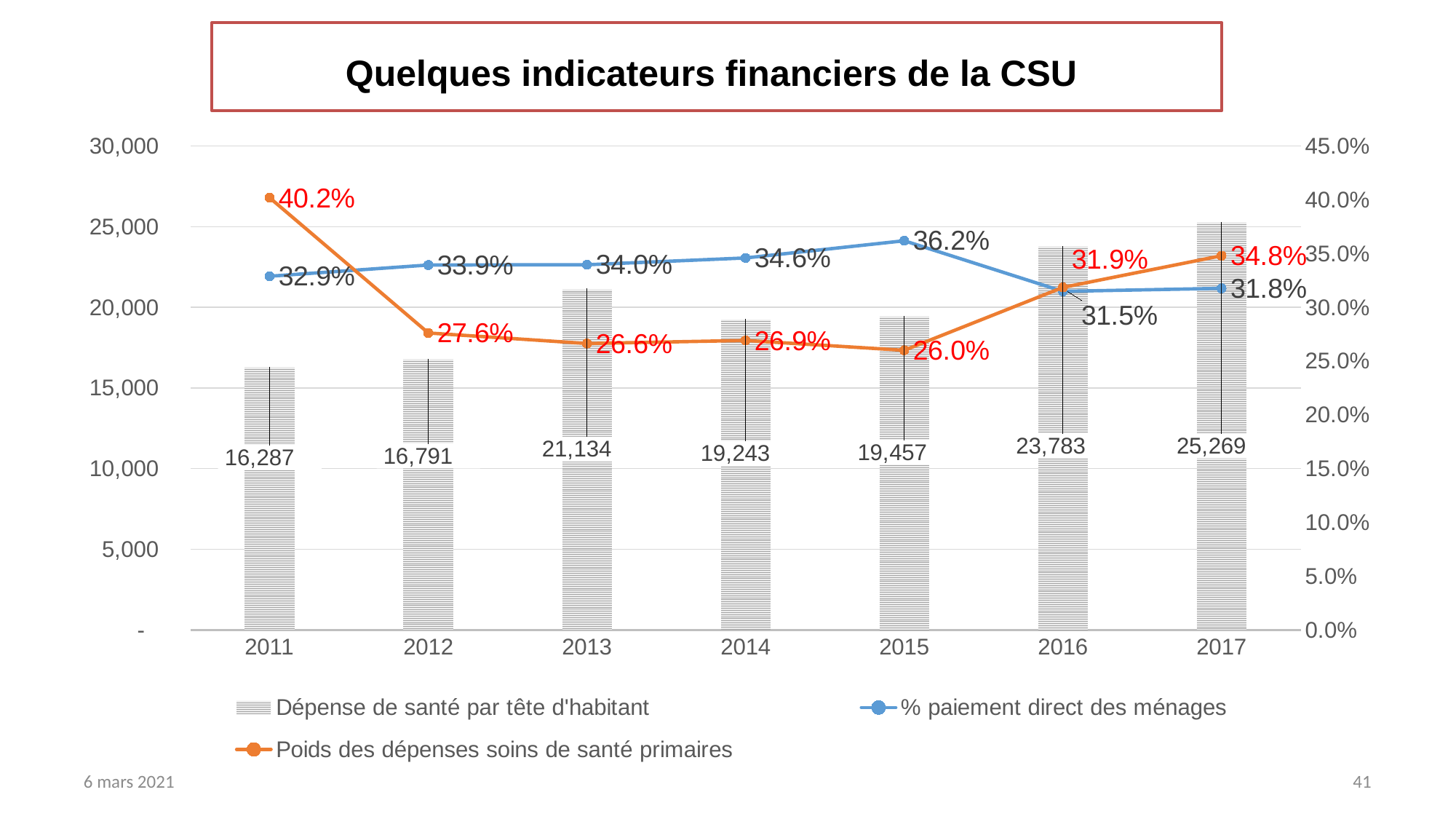
What kind of chart is this? Combined bar and line chart In which year is Poids des dépenses soins de santé primaires lowest? 2015 How many series does the legend list? 3 What is the % paiement direct des ménages in 2015? 36.2% What is the title of the chart? Quelques indicateurs financiers de la CSU Does the % paiement direct des ménages rise or fall from 2011 to 2015? Rise In which year is Dépense de santé par tête d'habitant highest? 2017 What is the value of Dépense de santé par tête d'habitant in 2013? 21,134 Which is larger in 2016: % paiement direct des ménages or Poids des dépenses soins de santé primaires? Poids des dépenses soins de santé primaires What is the difference in Dépense de santé par tête d'habitant between 2017 and 2016? 1,486 What is the Poids des dépenses soins de santé primaires in 2011? 40.2% How many years are shown on the x axis? 7